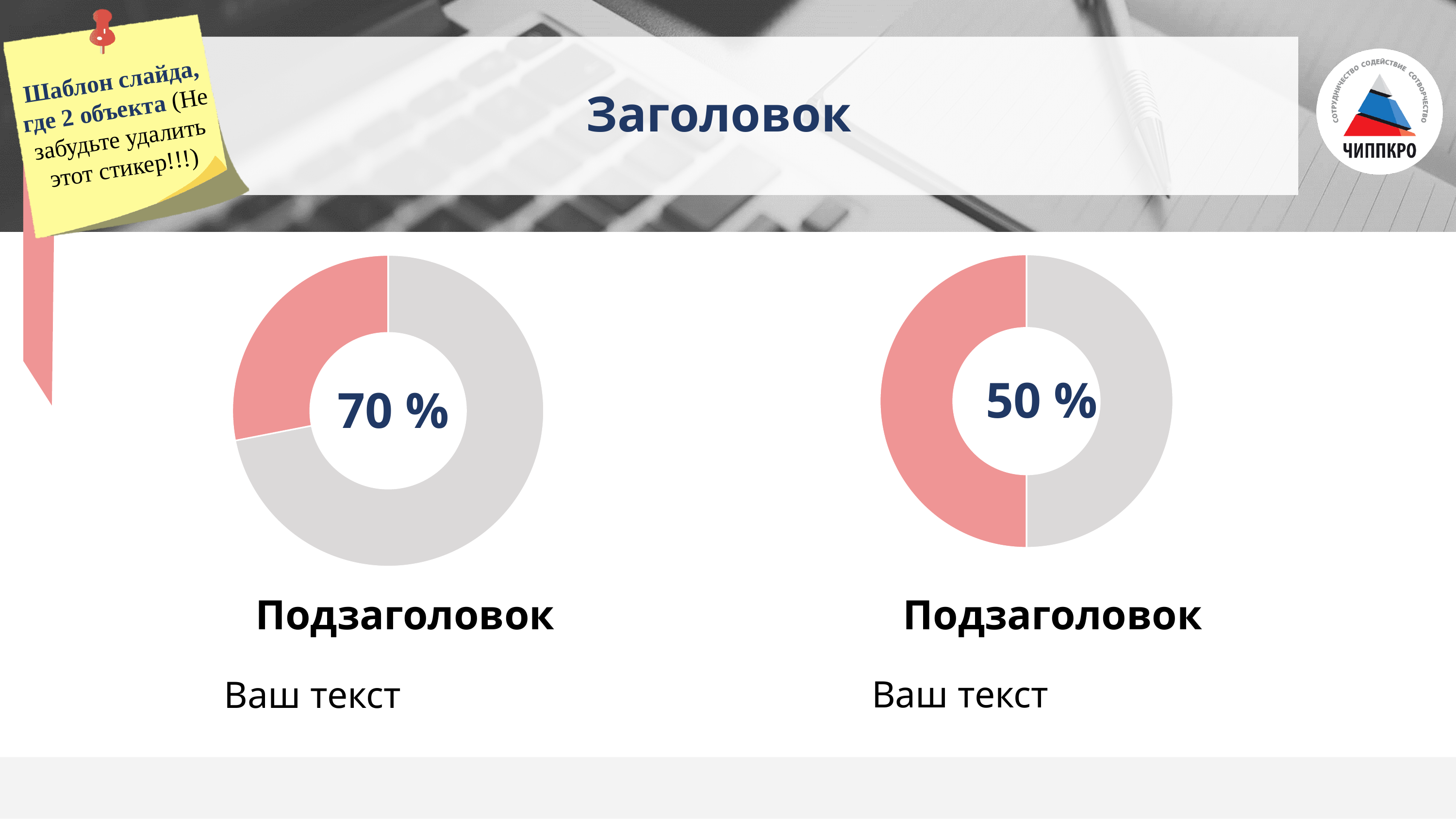
How many charts are shown on the slide? 2 What percentage is printed in the centre of the right donut chart? 50 % In the right donut chart, what share of the ring is coloured pink? 50 % Is the percentage printed in the left chart greater or less than 50? greater What is the difference between the percentage printed in the left chart and the percentage printed in the right chart? 20 % What kind of chart is used on this slide? Donut (pie) chart What is the title of the slide above the charts? Заголовок Which chart shows the larger printed percentage, the left one or the right one? The left one What percentage is printed in the centre of the left donut chart? 70 % What two colours are used for the segments of the donut charts? Pink and grey How many segments does each donut chart have? 2